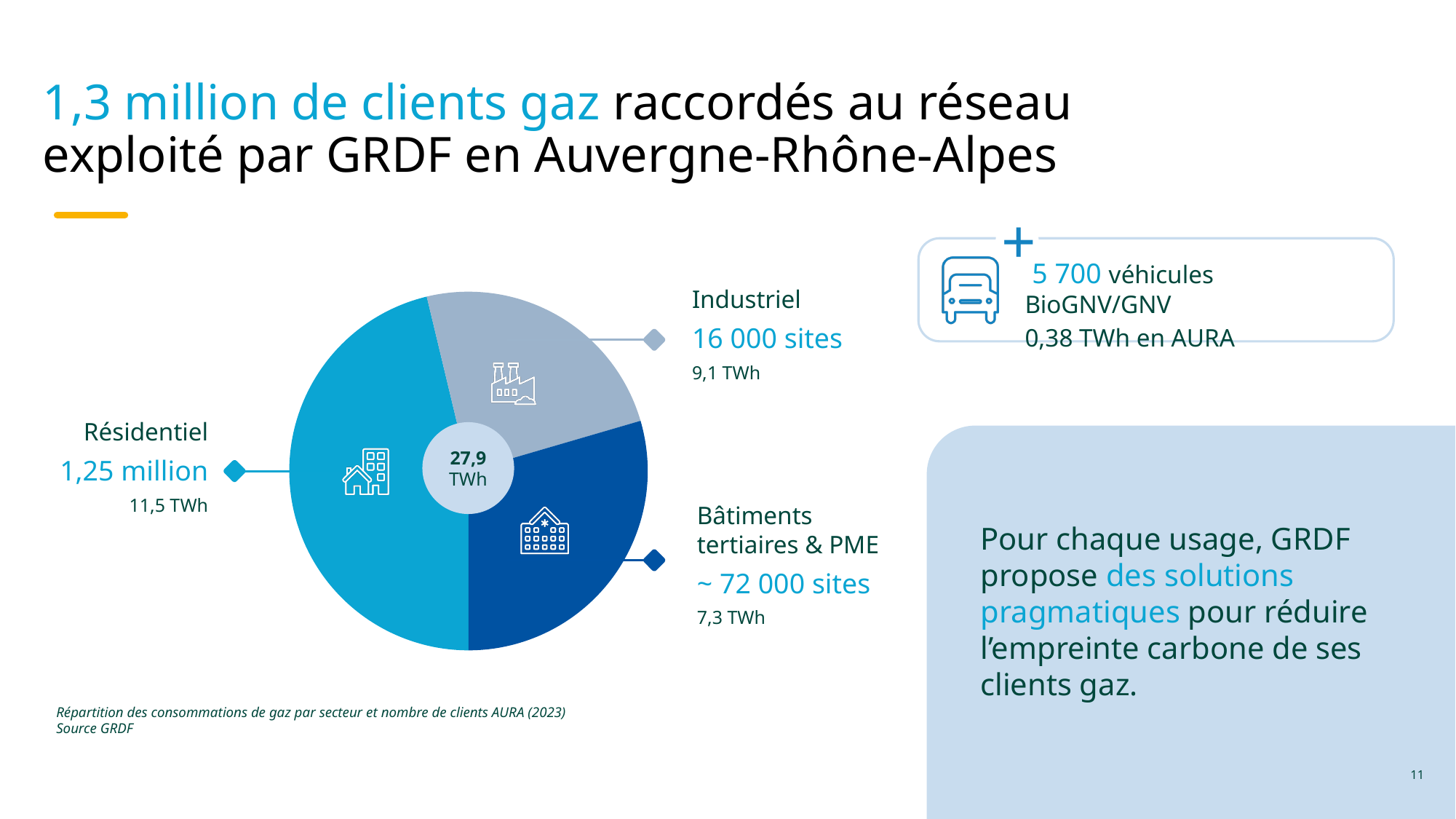
What is the difference in consumption between the Résidentiel and Industriel sectors? 2,4 TWh Which consumes more gas, the Industriel sector or Bâtiments tertiaires & PME? Industriel What type of chart is shown on the slide? Pie chart What is the gas consumption shown for the Résidentiel sector? 11,5 TWh According to the caption, what is the source of the chart data? GRDF What total consumption is shown in the centre of the pie chart? 27,9 TWh How many sectors does the pie chart divide gas consumption into? 3 What is the gas consumption shown for the Industriel sector? 9,1 TWh Which sector has the highest gas consumption in the pie chart? Résidentiel How many sites are listed for the Industriel sector? 16 000 sites Which sector has the lowest gas consumption in the pie chart? Bâtiments tertiaires & PME What is the gas consumption shown for Bâtiments tertiaires & PME? 7,3 TWh